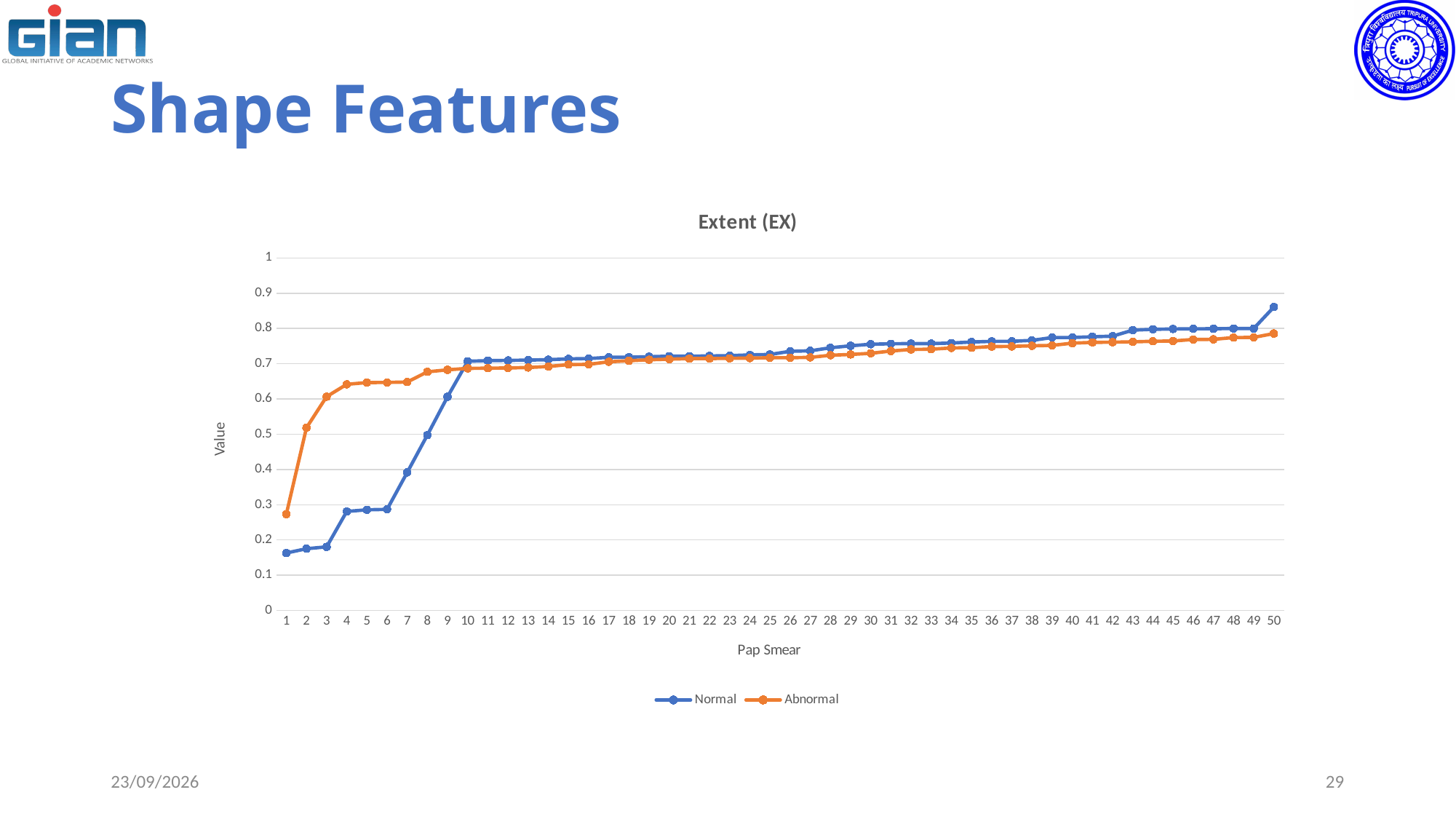
How many Pap Smear points are plotted along the x axis? 50 At which Pap Smear number does the Normal series reach its highest value? 50 At Pap Smear 5, which series has the larger value, Normal or Abnormal? Abnormal At Pap Smear 50, which series has the larger value, Normal or Abnormal? Normal How many series does the legend list? 2 Is the Normal value at Pap Smear 50 greater or less than 0.8? greater What kind of chart is shown on the slide? line chart Do the Normal values rise or fall as the Pap Smear number increases? rise Is the Normal value at Pap Smear 1 greater or less than 0.2? less What is the title of the chart? Extent (EX) Is the Normal value at Pap Smear 9 greater or less than 0.5? greater